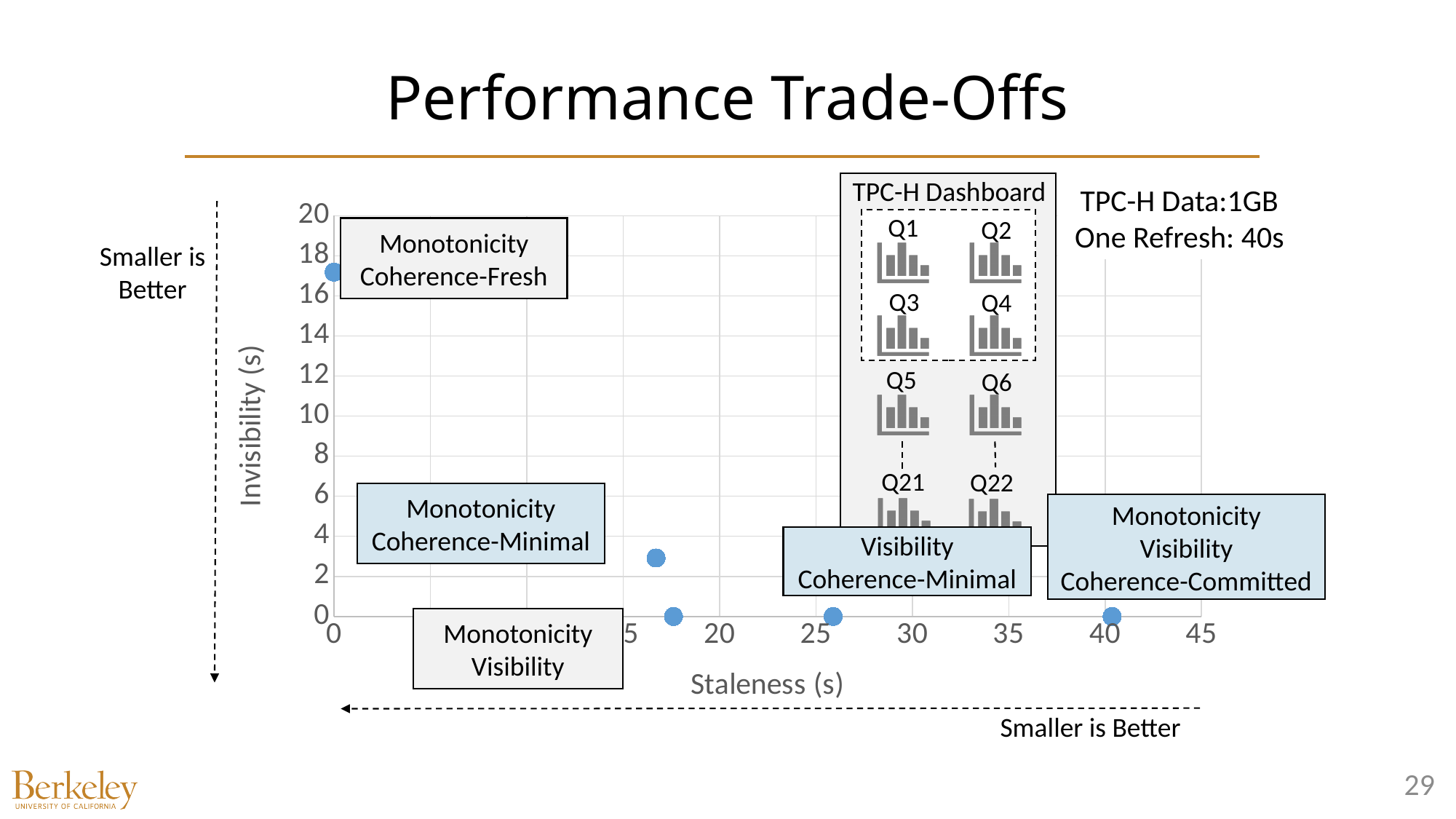
Which configuration has the lowest staleness? Monotonicity Coherence-Fresh How many data points are plotted on the chart? 5 Which configuration has the highest invisibility? Monotonicity Coherence-Fresh What is the staleness value for Monotonicity Coherence-Fresh? 0 Is the staleness value for Monotonicity Visibility Coherence-Committed greater or less than 35? greater Is the invisibility value for Monotonicity Coherence-Fresh greater or less than 10? greater Which has the larger staleness, Visibility Coherence-Minimal or Monotonicity Coherence-Minimal? Visibility Coherence-Minimal Which configuration has the highest staleness? Monotonicity Visibility Coherence-Committed What is the title of the chart's y axis? Invisibility (s) What is the invisibility value for Visibility Coherence-Minimal? 0 What is the title of the chart's x axis? Staleness (s) What kind of chart is shown on the slide? Scatter chart